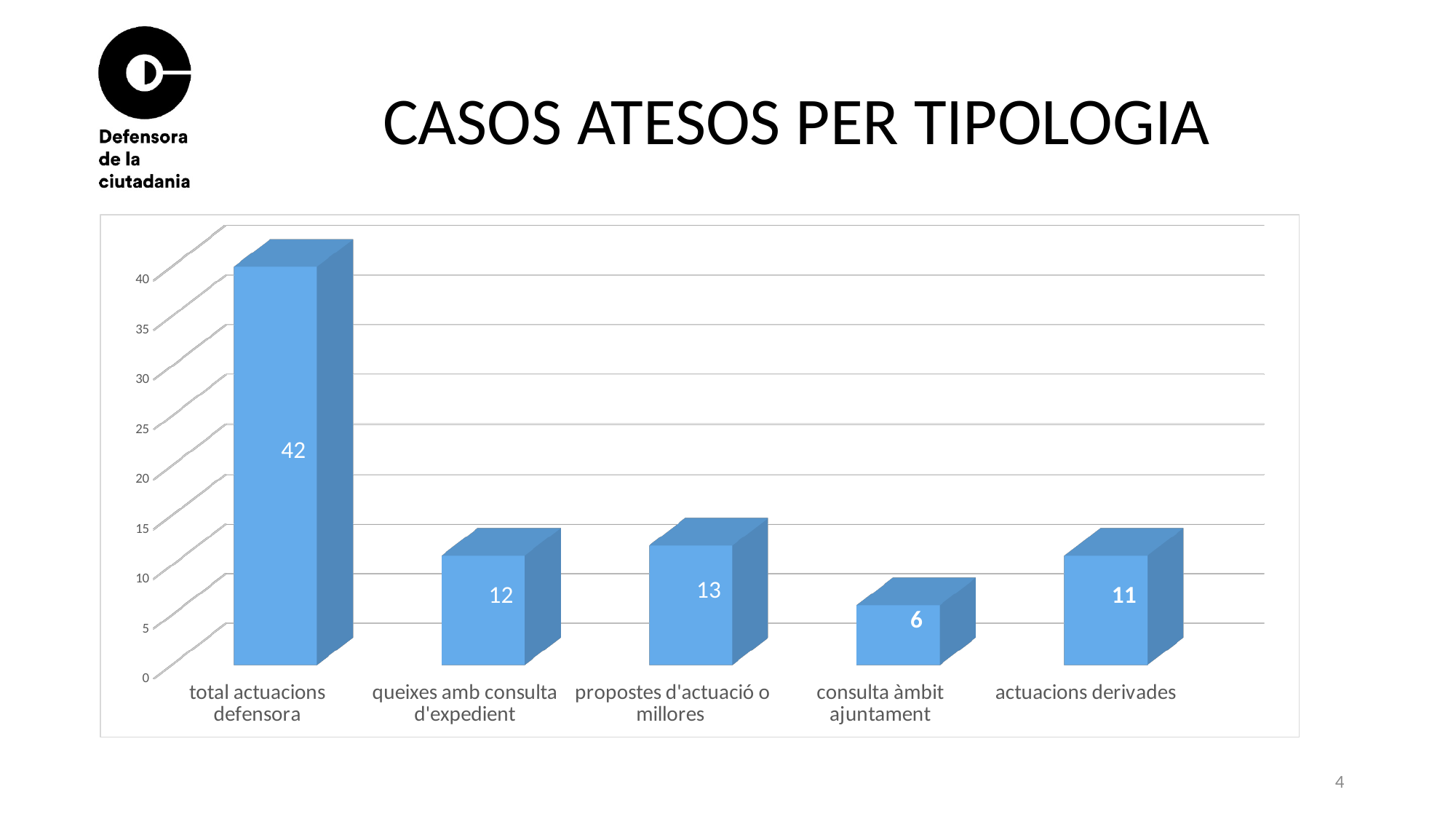
What is the value for 'queixes amb consulta d'expedient'? 12 Which category has the highest value? total actuacions defensora How many categories are shown in the chart? 5 What is the title of the slide? CASOS ATESOS PER TIPOLOGIA What is the value for 'actuacions derivades'? 11 Is the value for 'queixes amb consulta d'expedient' greater or less than 10? greater What is the value for 'total actuacions defensora'? 42 What kind of chart is shown on the slide? bar chart What is the difference between 'total actuacions defensora' and 'propostes d'actuació o millores'? 29 Which category has the lowest value? consulta àmbit ajuntament Which is larger, 'propostes d'actuació o millores' or 'actuacions derivades'? propostes d'actuació o millores What is the value for 'consulta àmbit ajuntament'? 6